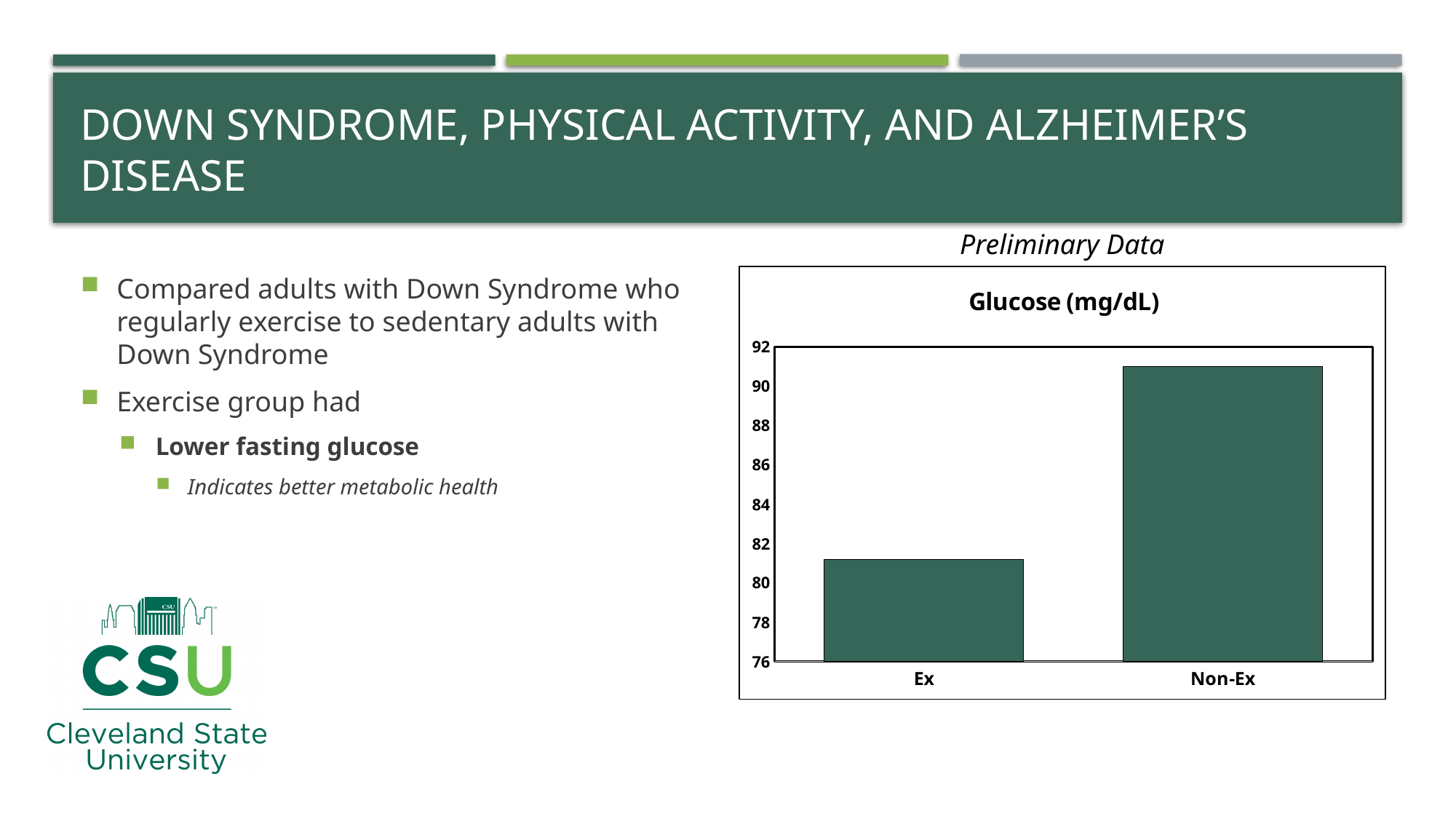
Is the value for Ex greater or less than 80? greater What label appears in italics directly above the chart? Preliminary Data What kind of chart is shown on the slide? bar chart Do the values rise or fall from Ex to Non-Ex along the x axis? rise Which has the larger glucose value, Ex or Non-Ex? Non-Ex How many categories are plotted on the x axis of the chart? 2 Which category has the lowest glucose value? Ex What is the title of the chart? Glucose (mg/dL) Is the value for Ex greater or less than 84? less Is the value for Non-Ex greater or less than 92? less Which category has the highest glucose value? Non-Ex